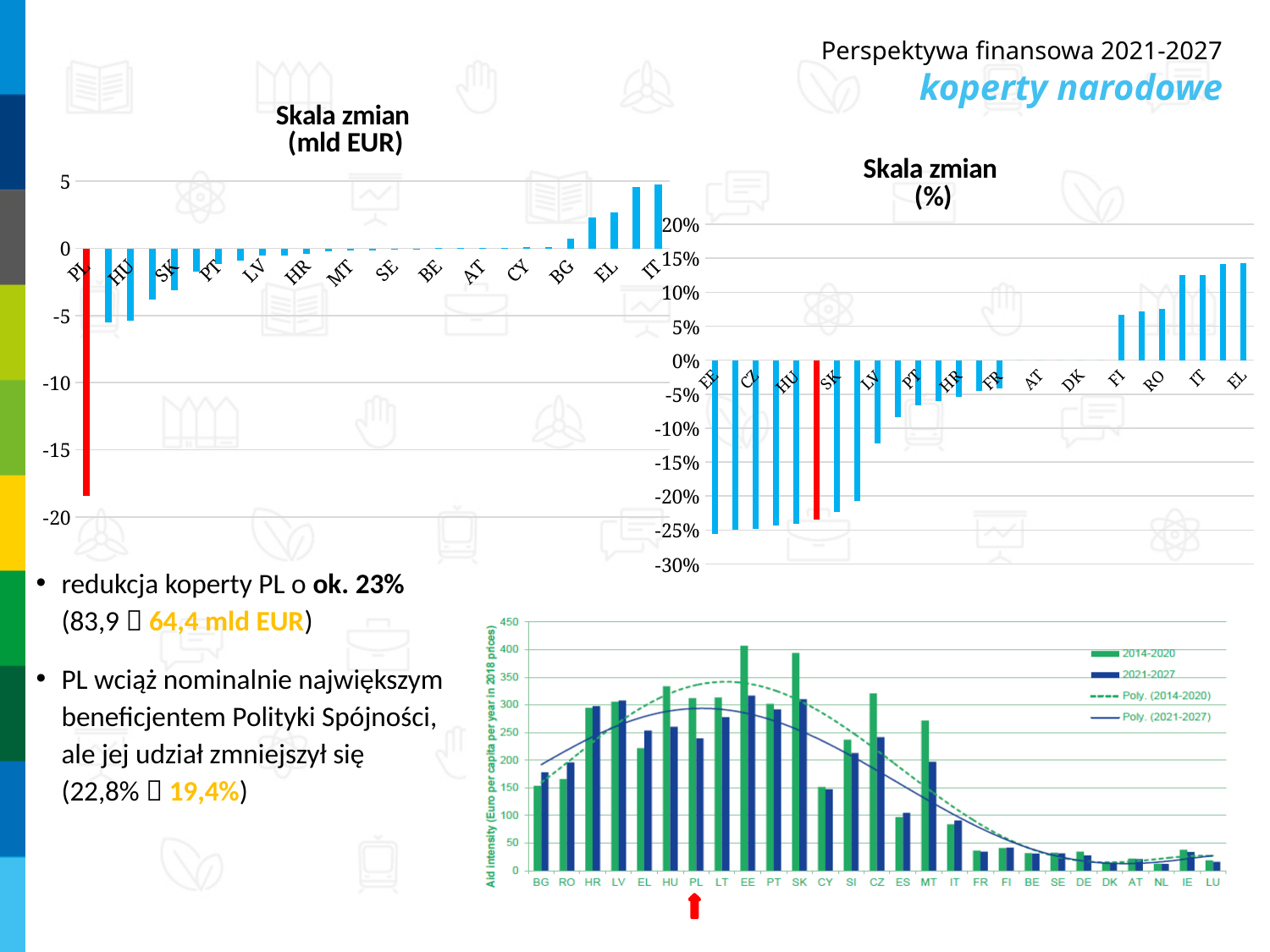
In the chart titled "Skala zmian (%)", which country has the lowest value? EE In the bottom chart (Aid intensity), which country has the highest 2014-2020 bar? EE In the chart titled "Skala zmian (mld EUR)", which country has the highest value? IT In the chart titled "Skala zmian (mld EUR)", is the value for PL greater or less than -15? less In the chart titled "Skala zmian (%)", which country has the highest value? EL In the chart titled "Skala zmian (%)", is the value for EE greater or less than -20%? less In the bottom chart (Aid intensity), for PL, which series has the larger value: 2014-2020 or 2021-2027? 2014-2020 In the bottom chart (Aid intensity), how many entries does the legend list? 4 In the chart titled "Skala zmian (%)", is the value for IT greater or less than 10%? greater In the chart titled "Skala zmian (mld EUR)", which country has the lowest value? PL